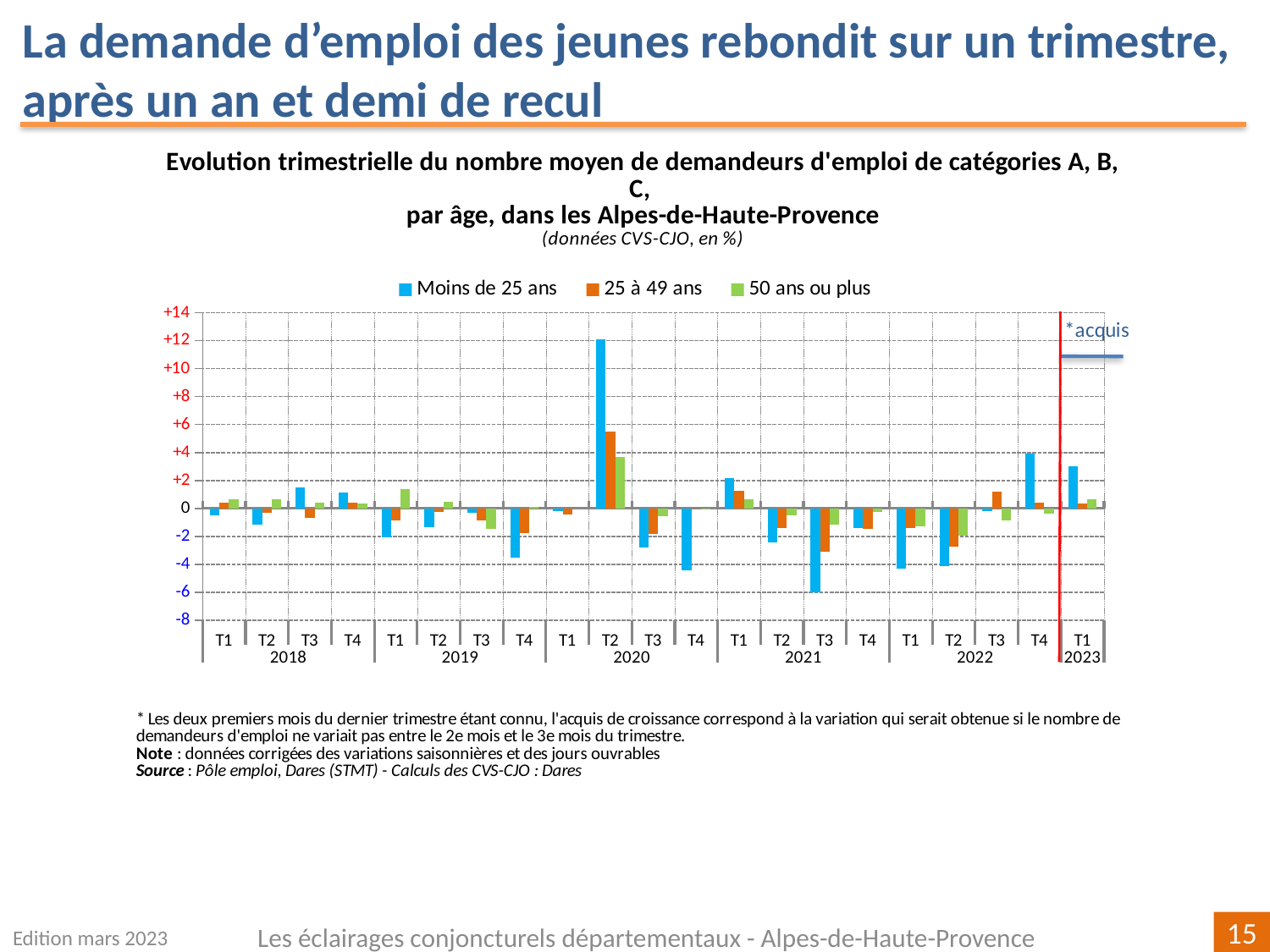
Which colour represents the '25 à 49 ans' series? orange Which quarter is marked with the red vertical line and the label '*acquis'? T1 2023 Is the value for '25 à 49 ans' in T2 2020 greater or less than +4? greater How many quarters are plotted along the x axis? 21 How many series does the legend list? 3 In which quarter does the 'Moins de 25 ans' series reach its highest value? T2 2020 Is the value for 'Moins de 25 ans' in T2 2020 greater or less than +10? greater Is the value for 'Moins de 25 ans' in T3 2021 greater or less than -4? less In which quarter does the 'Moins de 25 ans' series reach its lowest value? T3 2021 In T2 2020, which series has the larger value: 'Moins de 25 ans' or '50 ans ou plus'? Moins de 25 ans What kind of chart is shown on the slide? bar chart